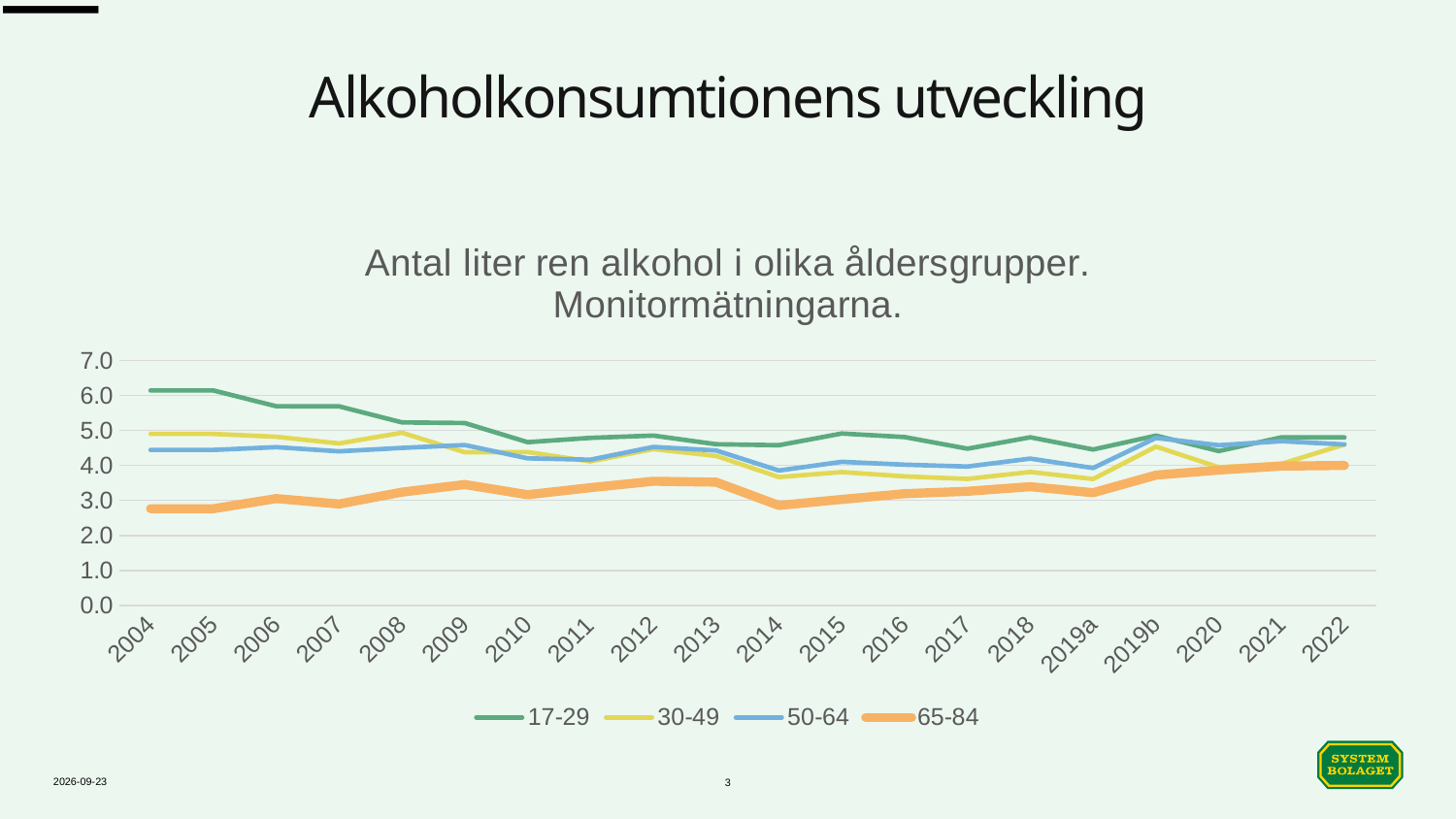
Is the value for 50-64 in 2004 greater or less than 4.0? greater Which age group has the lowest value in 2004? 65-84 What kind of chart is shown on the slide? line chart Is the value for 65-84 in 2004 greater or less than 3.0? less How many series does the legend list? 4 Does the 65-84 line rise or fall overall from 2004 to 2022? rise Is the value for 17-29 in 2004 greater or less than 6.0? greater How many points are plotted along the x axis for each series? 20 What is the title of the chart? Antal liter ren alkohol i olika åldersgrupper. Monitormätningarna. Which age group has the lowest value in 2022? 65-84 Does the 17-29 line rise or fall overall from 2004 to 2022? fall Which age group has the highest value in 2004? 17-29